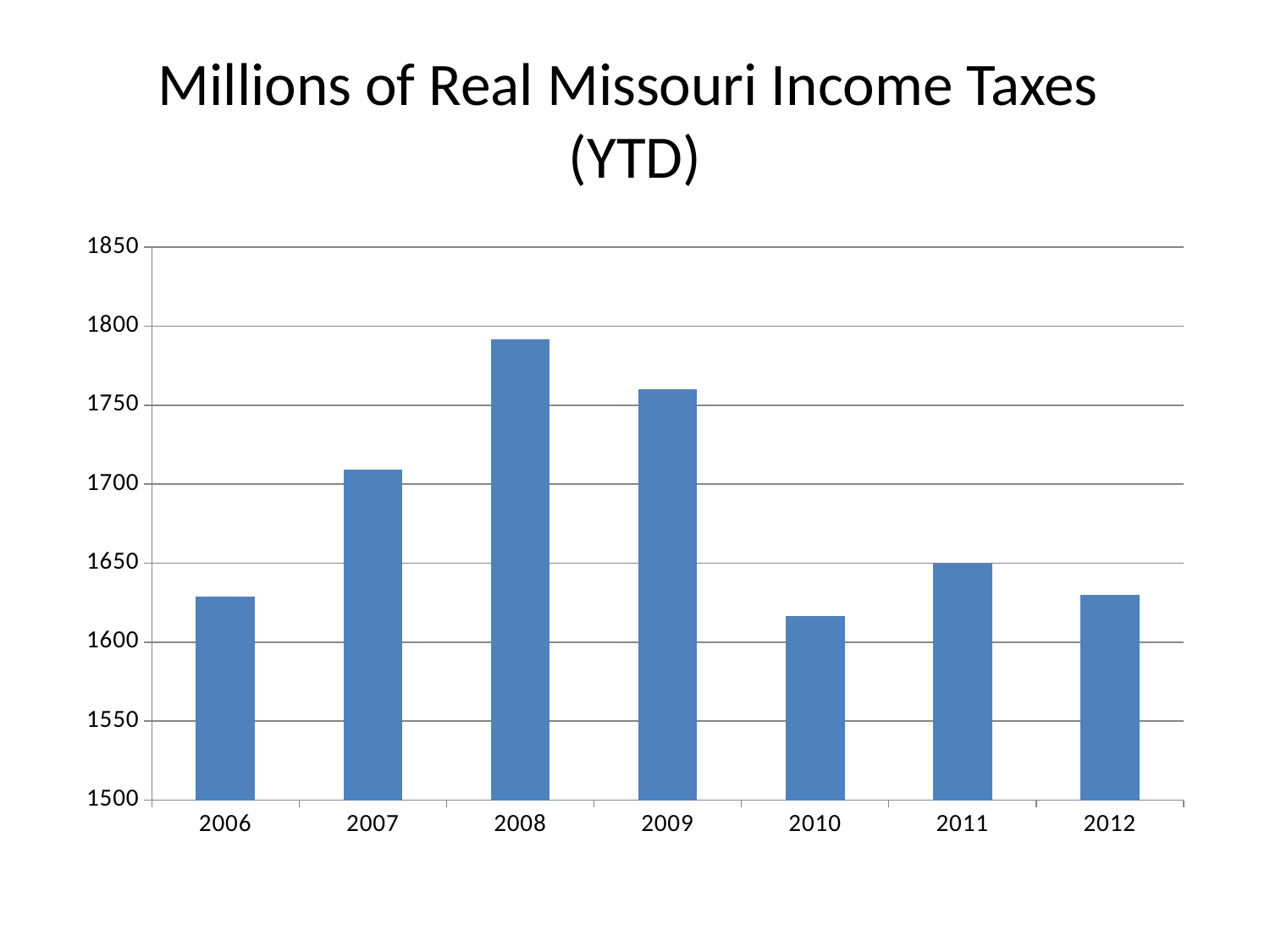
Do the values rise or fall from 2006 to 2008? rise How many years are shown on the x axis of the chart? 7 Which is larger, the value for 2008 or the value for 2009? 2008 Is the value for 2006 greater or less than 1600? greater Which is larger, the value for 2007 or the value for 2011? 2007 Which year has the lowest value in the chart? 2010 Which year has the highest value in the chart? 2008 Is the value for 2009 greater or less than 1750? greater Is the value for 2008 greater or less than 1800? less What kind of chart is shown on the slide? bar chart What is the title of the chart? Millions of Real Missouri Income Taxes (YTD)